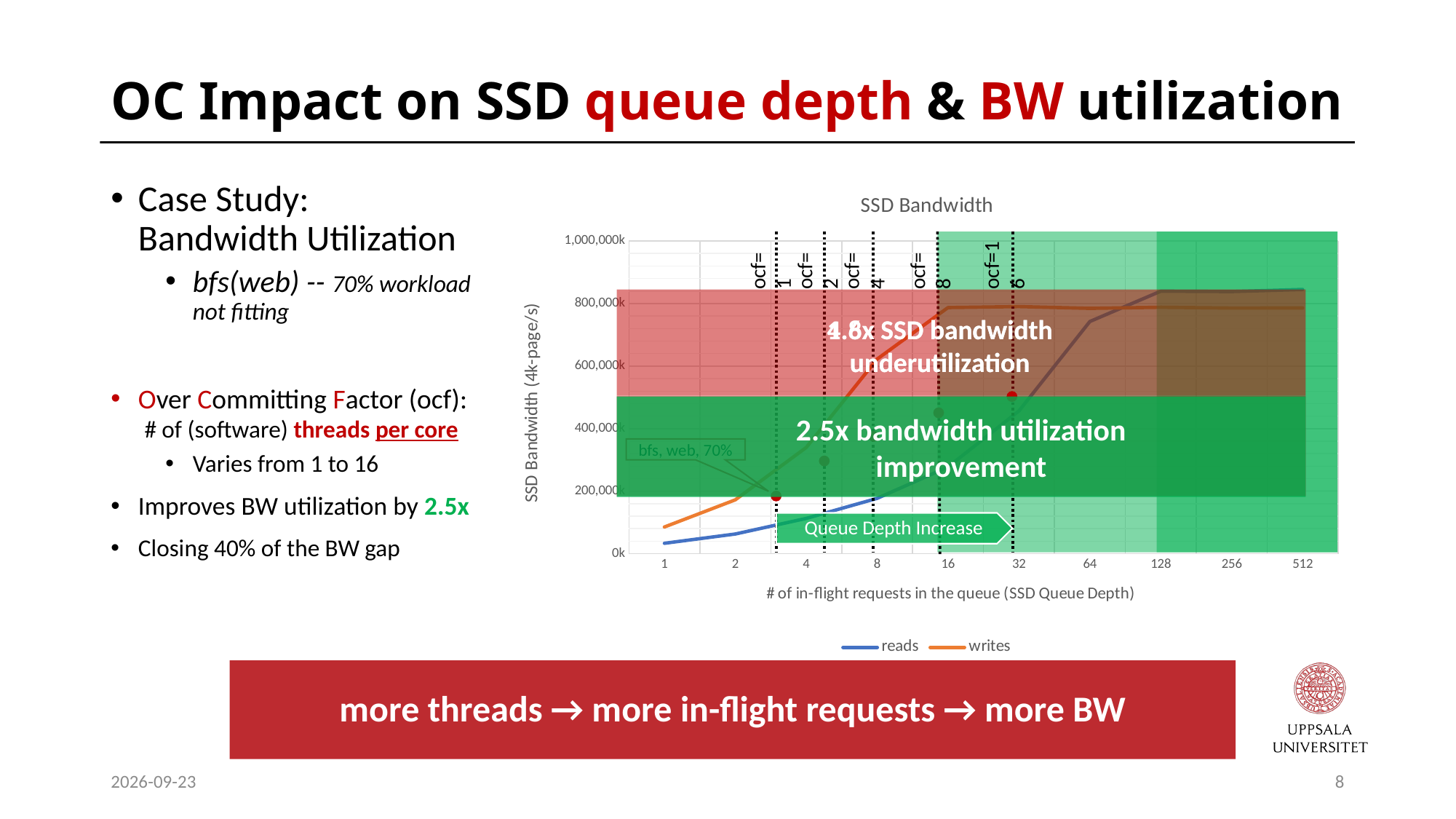
What is the title of the chart? SSD Bandwidth Does the reads series rise or fall as the queue depth increases from 1 to 512? rise What type of chart is shown on the slide? line chart Is the value of the reads series at queue depth 512 greater or less than 600,000k? greater At queue depth 4, which series has the higher bandwidth, reads or writes? writes How many series does the chart legend list? 2 Is the value of the writes series at queue depth 512 greater or less than 600,000k? greater What is the largest queue depth value shown on the x axis? 512 How many queue depth values are marked on the x axis of the chart? 10 Which series are listed in the chart legend? reads, writes Does the writes series rise or fall as the queue depth increases from 1 to 16? rise Is the value of the reads series at queue depth 4 greater or less than 200,000k? less